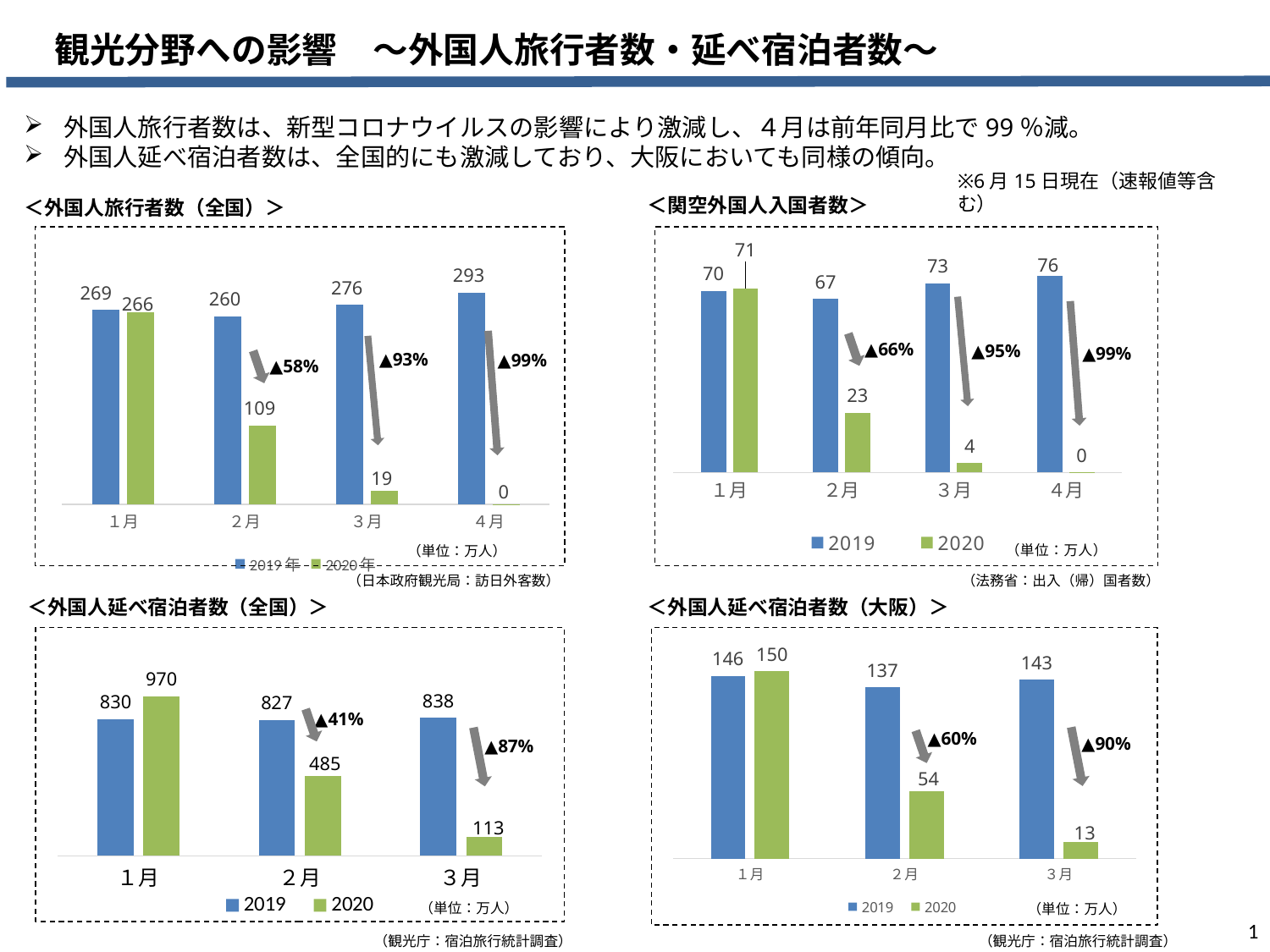
In the 外国人延べ宿泊者数（大阪） chart (bottom right), what is the difference between the 2019 and 2020 values for 2月? 83 In the 外国人旅行者数（全国） chart (top left), what is the difference between the 2019 and 2020 values for 3月? 257 In the 関空外国人入国者数 chart (top right), which month has the lowest 2020 value? 4月 In the 外国人延べ宿泊者数（大阪） chart (bottom right), what is the 2020 value for 3月? 13 In the 外国人旅行者数（全国） chart (top left), what is the 2020 value for 2月? 109 In the 外国人延べ宿泊者数（全国） chart (bottom left), what is the 2020 value for 1月? 970 In the 外国人延べ宿泊者数（全国） chart (bottom left), how many months are shown on the x axis? 3 In the 外国人旅行者数（全国） chart (top left), which month has the highest 2019 value? 4月 What type of chart is the 外国人延べ宿泊者数（大阪） chart (bottom right)? Bar chart In the 関空外国人入国者数 chart (top right), how many series does the legend list? 2 In the 外国人延べ宿泊者数（全国） chart (bottom left), which is larger for 3月, the 2019 value or the 2020 value? 2019 In the 関空外国人入国者数 chart (top right), what is the 2020 value for 2月? 23